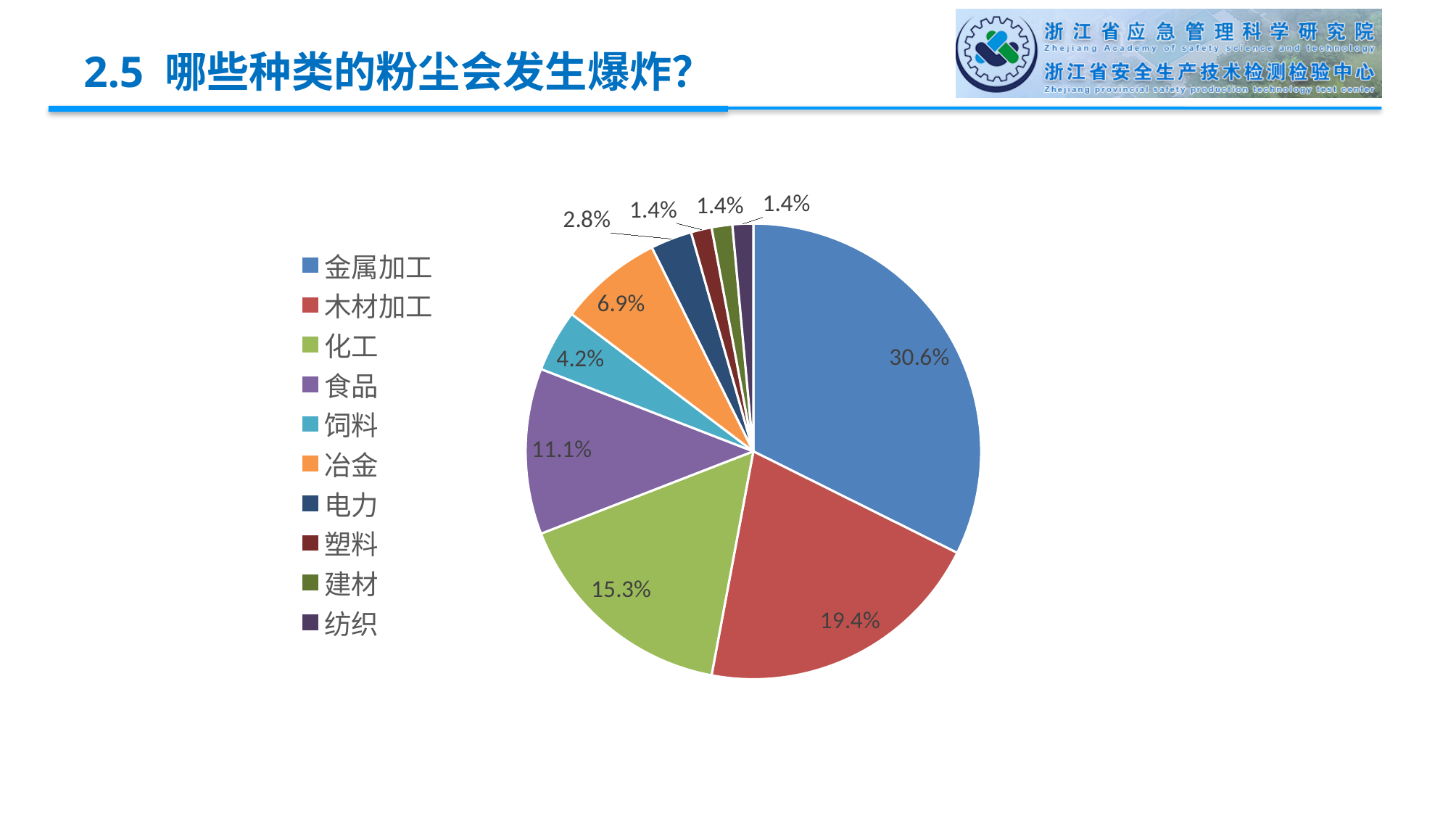
How many categories does the legend list? 10 What is the difference between the shares of 金属加工 and 木材加工? 11.2% What share of the pie does 金属加工 account for? 30.6% What is the value shown for 食品? 11.1% What is the value shown for 饲料? 4.2% What is the value shown for 冶金? 6.9% What is the value shown for 化工? 15.3% What kind of chart is shown on the slide? Pie chart What colour is the slice for 冶金? Orange Which category has the largest slice of the pie? 金属加工 What is the value shown for 木材加工? 19.4% Which is larger, the share for 化工 or the share for 食品? 化工